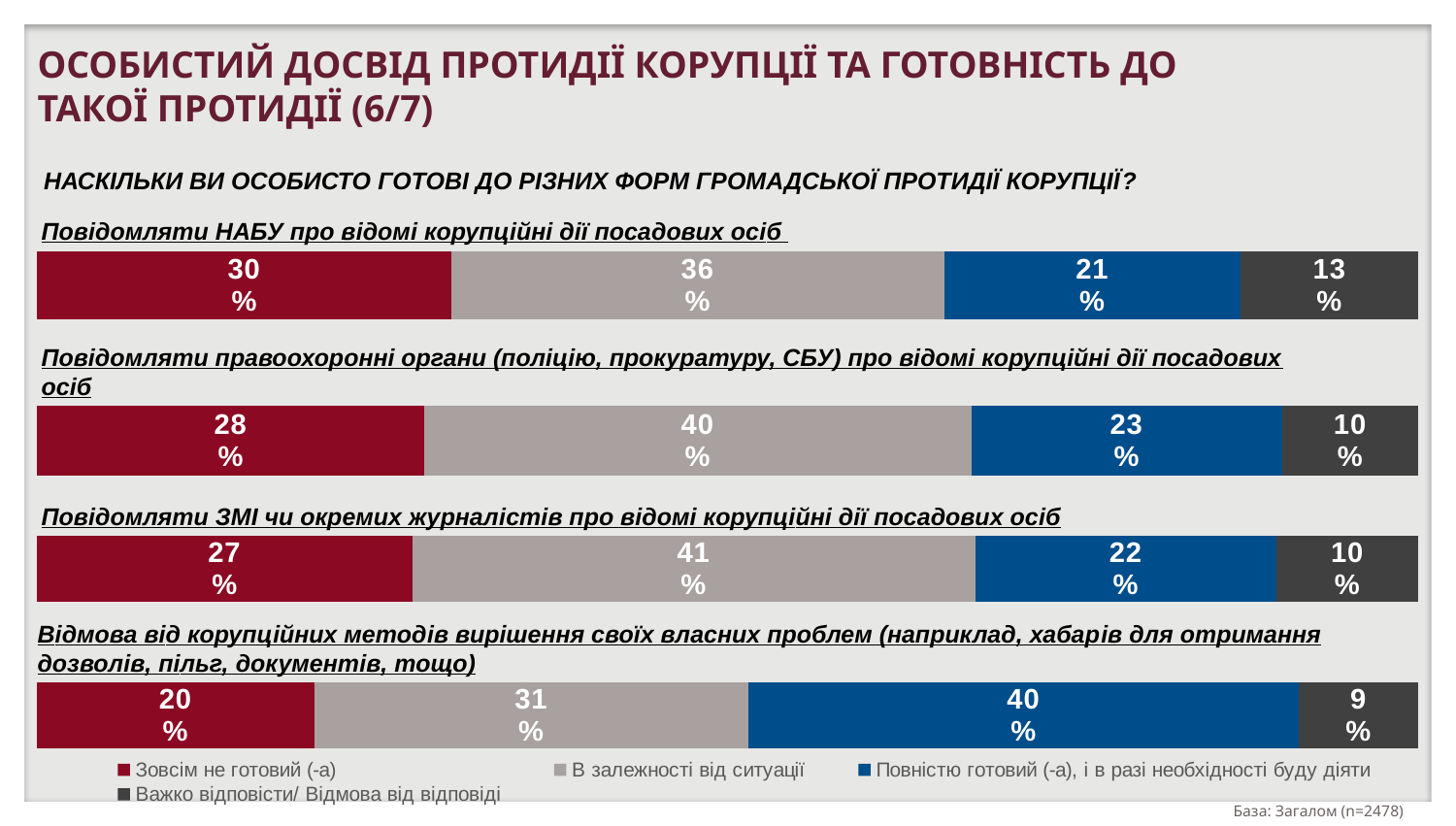
In the chart 'Відмова від корупційних методів вирішення своїх власних проблем', which response category has the highest value? Повністю готовий (-а), і в разі необхідності буду діяти In the chart 'Відмова від корупційних методів вирішення своїх власних проблем', what is the value for 'Важко відповісти/ Відмова від відповіді'? 9% In the chart 'Повідомляти НАБУ про відомі корупційні дії посадових осіб', what is the value for 'Зовсім не готовий (-а)'? 30% In the chart 'Повідомляти правоохоронні органи (поліцію, прокуратуру, СБУ) про відомі корупційні дії посадових осіб', which is larger: 'Зовсім не готовий (-а)' or 'Повністю готовий (-а), і в разі необхідності буду діяти'? Зовсім не готовий (-а) In the chart 'Повідомляти НАБУ про відомі корупційні дії посадових осіб', which response category has the lowest value? Важко відповісти/ Відмова від відповіді In the chart 'Відмова від корупційних методів вирішення своїх власних проблем', which is larger: 'Зовсім не готовий (-а)' or 'В залежності від ситуації'? В залежності від ситуації In the chart 'Повідомляти ЗМІ чи окремих журналістів про відомі корупційні дії посадових осіб', what is the value for 'Повністю готовий (-а), і в разі необхідності буду діяти'? 22% In the chart 'Повідомляти ЗМІ чи окремих журналістів про відомі корупційні дії посадових осіб', what is the difference between 'В залежності від ситуації' and 'Зовсім не готовий (-а)'? 14 percentage points How many series does the legend list? 4 What kind of chart is used on this slide? Stacked bar chart What colour represents 'Повністю готовий (-а), і в разі необхідності буду діяти' in the legend? Blue In the chart 'Повідомляти правоохоронні органи (поліцію, прокуратуру, СБУ) про відомі корупційні дії посадових осіб', what is the value for 'В залежності від ситуації'? 40%